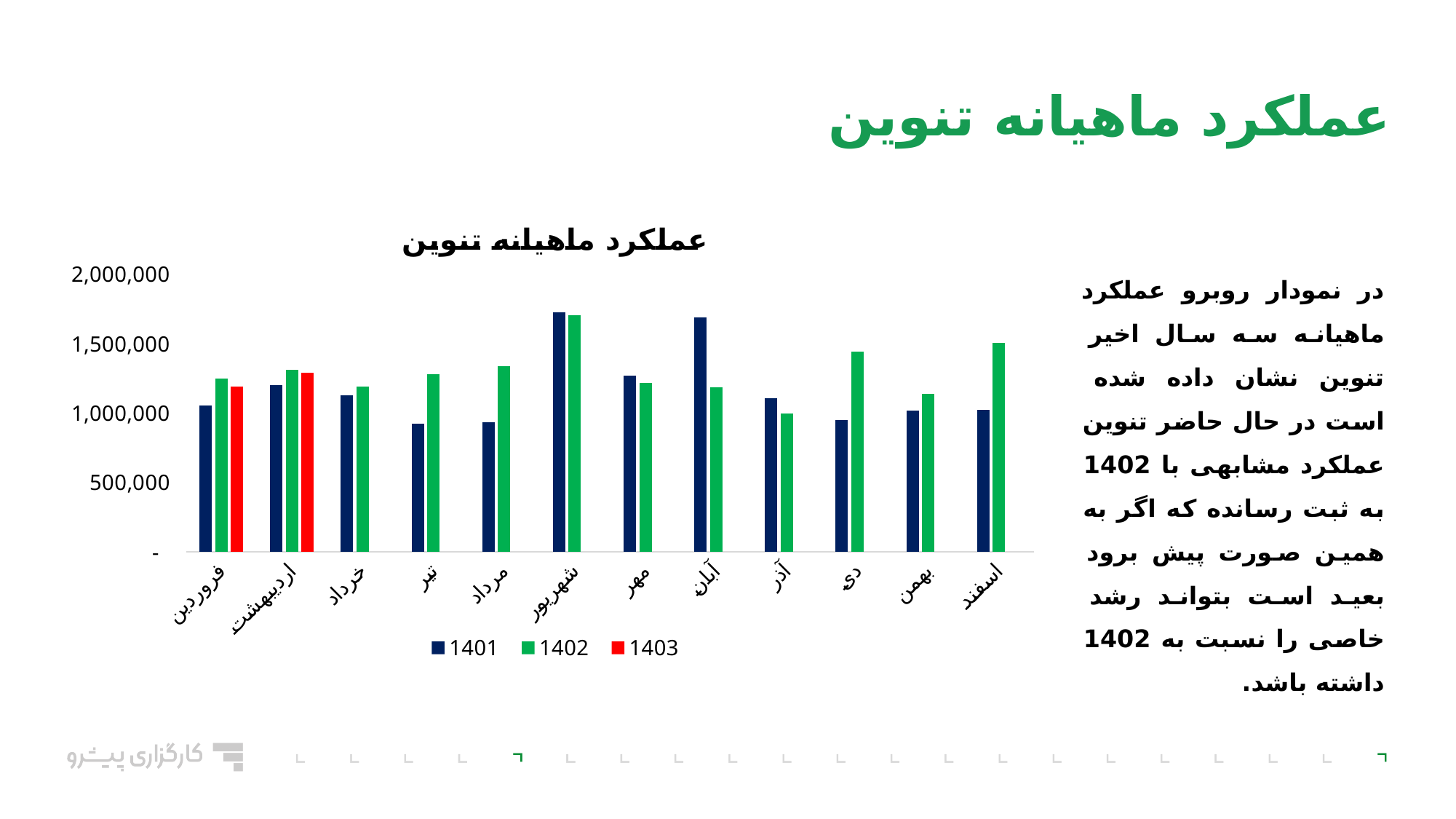
Is the value for 1401 in آبان greater or less than 1,500,000? greater In آبان, which series has the larger value, 1401 or 1402? 1401 Is the value for 1401 in تیر greater or less than 1,000,000? less Which month has the lowest value for the 1402 series? آذر What kind of chart is shown on the slide? bar chart What is the title of the chart? عملکرد ماهیانه تنوین For how many months does the 1403 series have a bar? 2 In دی, which series has the larger value, 1401 or 1402? 1402 Which series are listed in the legend? 1401, 1402, 1403 Which month has the highest value for the 1402 series? شهریور How many months (categories) are shown on the x axis? 12 How many series does the legend list? 3